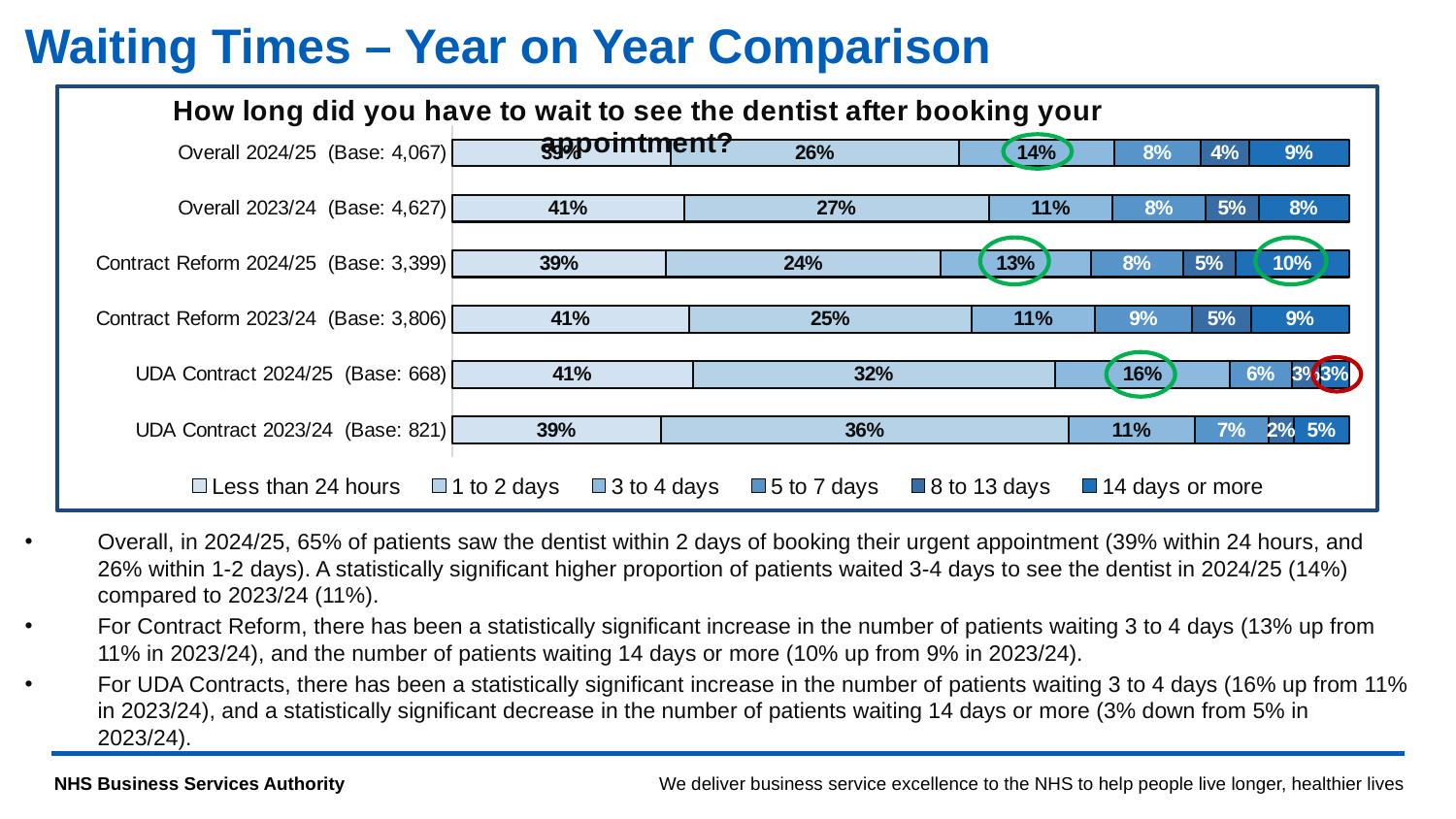
Which category has the highest value for 1 to 2 days? UDA Contract 2023/24 What is the value for 3 to 4 days for UDA Contract 2024/25? 16% What is the value for 14 days or more for Contract Reform 2024/25? 10% What percentage of Overall 2023/24 patients waited less than 24 hours? 41% How many categories (bars) are plotted in the chart? 6 What is the value for 1 to 2 days for UDA Contract 2023/24? 36% How many series does the legend list? 6 By how many percentage points does the 3 to 4 days value for Overall 2024/25 exceed that for Overall 2023/24? 3 percentage points Which has the larger 1 to 2 days value: UDA Contract 2023/24 or Contract Reform 2023/24? UDA Contract 2023/24 What is the value for 5 to 7 days for Contract Reform 2023/24? 9% What is the first entry in the chart's legend? Less than 24 hours What kind of chart is shown on the slide? Stacked bar chart